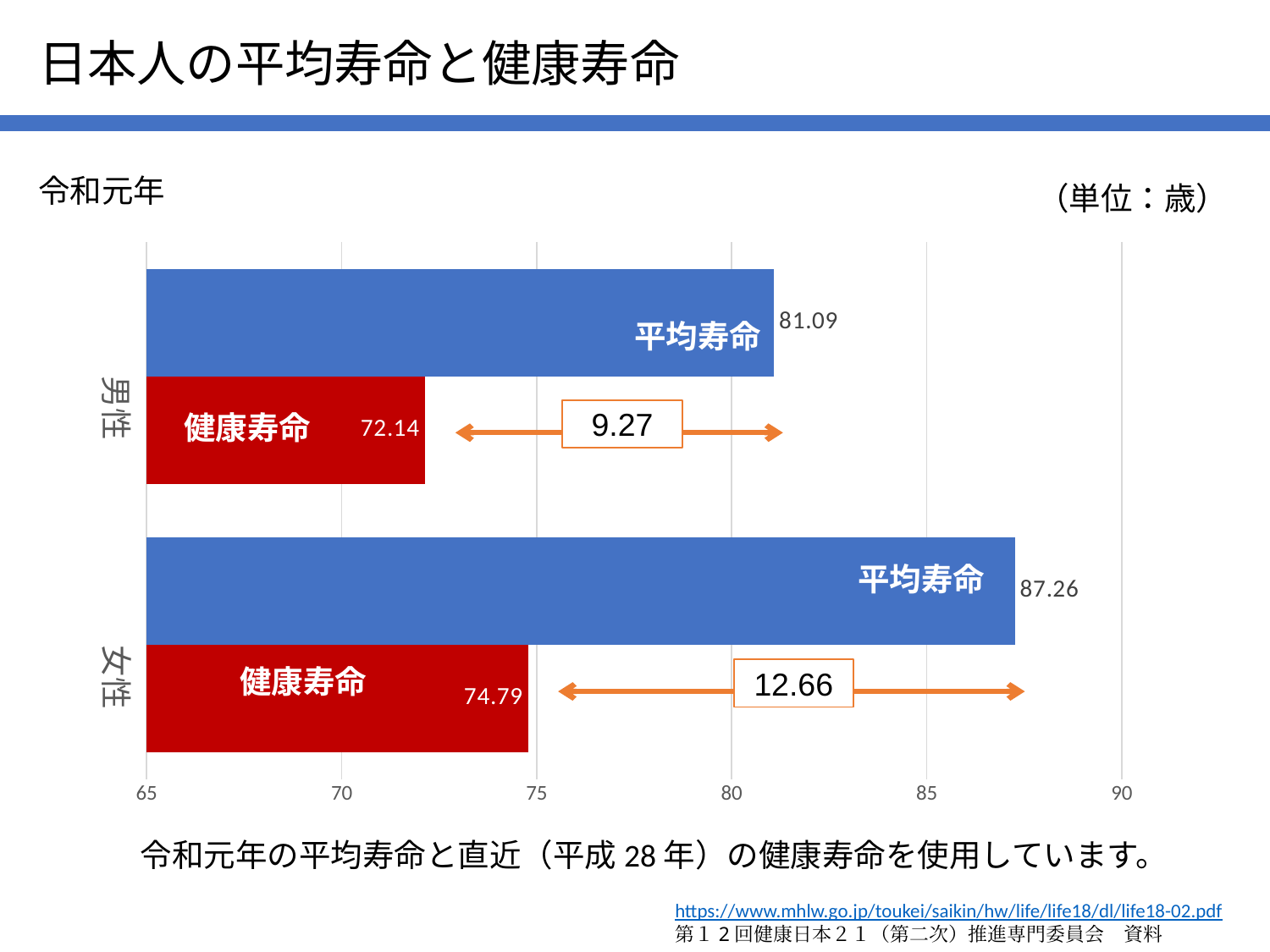
What is the 健康寿命 value for 男性? 72.14 What is the 平均寿命 value for 女性? 87.26 How many categories (groups) are shown on the chart? 2 What is the difference between 平均寿命 and 健康寿命 for 女性? 12.66 Which is larger, the 健康寿命 for 男性 or the 健康寿命 for 女性? 女性 What is the difference between 平均寿命 and 健康寿命 for 男性? 9.27 Which bar has the highest value on the chart? 女性 平均寿命 Is the 平均寿命 value for 女性 greater or less than 85? greater What is the 健康寿命 (healthy life expectancy) value for 女性 (women)? 74.79 Which bar has the lowest value on the chart? 男性 健康寿命 What kind of chart is shown on the slide? Bar chart What is the 平均寿命 (average life expectancy) value for 男性 (men)? 81.09